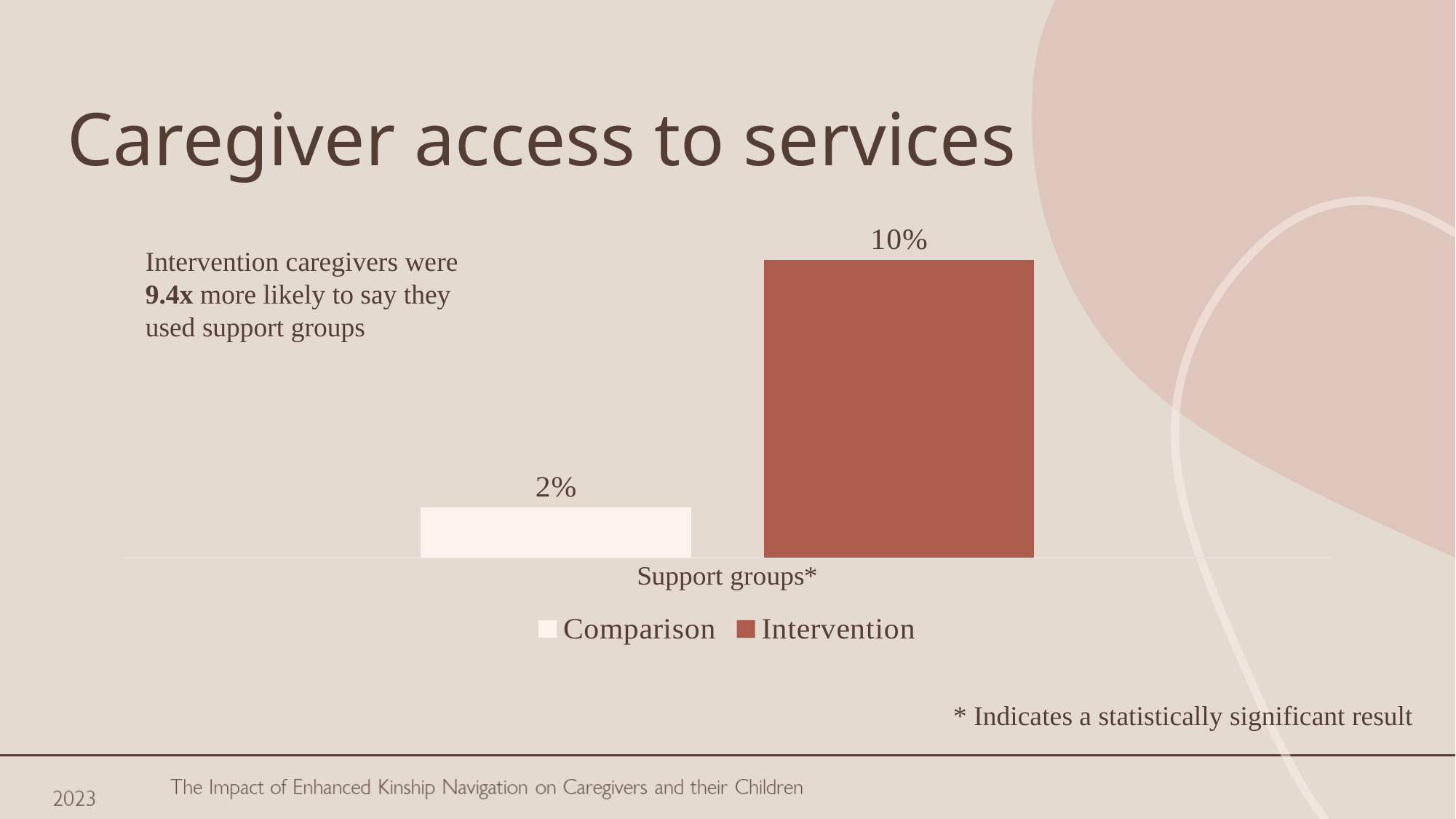
How many categories are shown on the x axis? 1 What is the value for the Comparison group for Support groups? 2% Which series is shown in the darker red-brown colour? Intervention What is the difference between the Intervention and Comparison values for Support groups? 8% Is the Comparison value or the Intervention value larger for Support groups? Intervention What kind of chart is shown on the slide? Bar chart How many series does the legend list? 2 Which series has the higher value for Support groups? Intervention Which series has the lower value for Support groups? Comparison What is the category label on the x axis? Support groups* What is the value for the Intervention group for Support groups? 10%